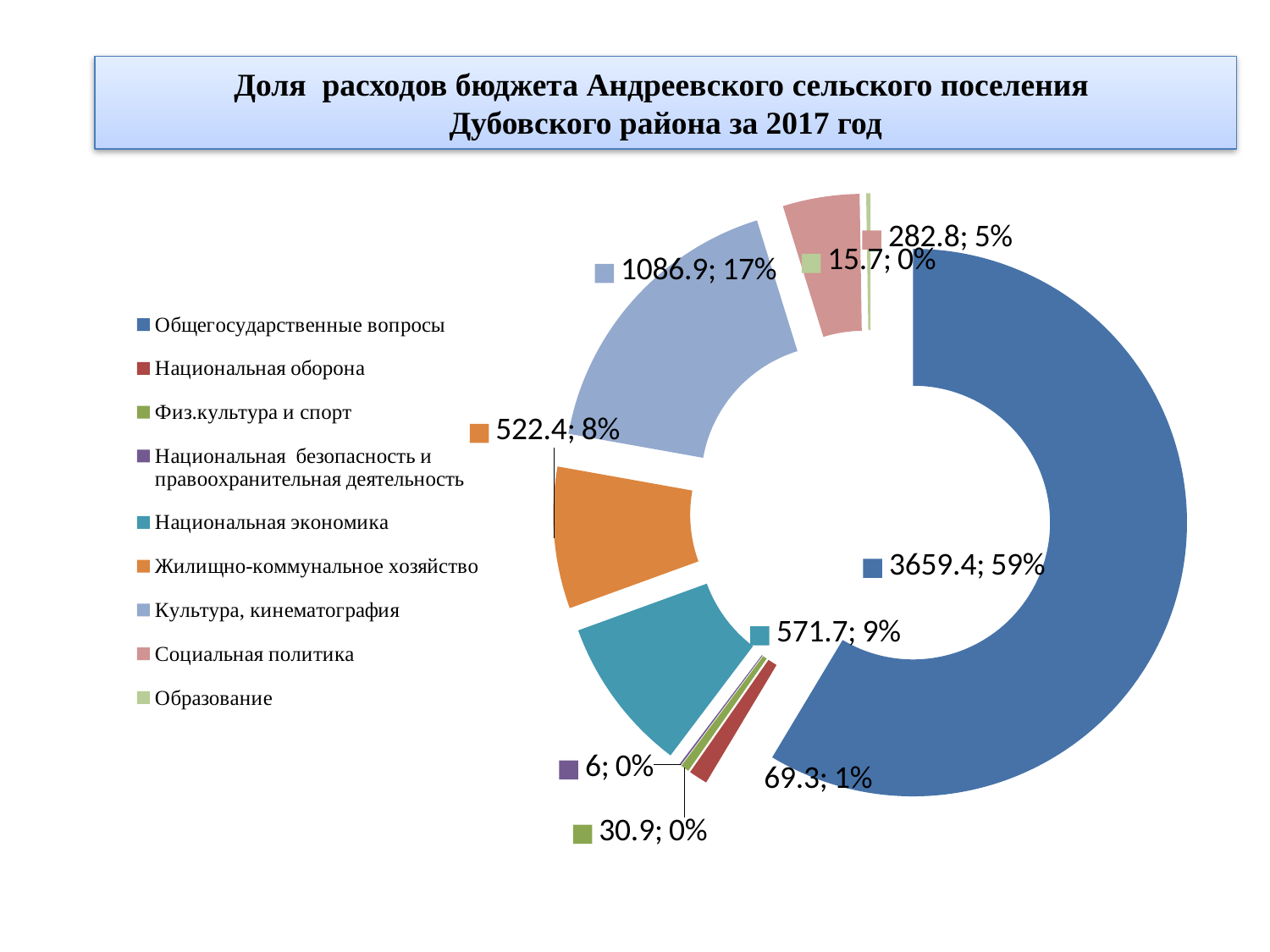
What share of the chart does Национальная экономика take? 9% Which is larger, the value for Социальная политика or the value for Национальная оборона? Социальная политика Which category has the largest value? Общегосударственные вопросы How many categories does the legend list? 9 What is the difference between the values for Национальная экономика and Жилищно-коммунальное хозяйство? 49.3 Which category has the smallest value? Национальная безопасность и правоохранительная деятельность What value is shown for Общегосударственные вопросы? 3659.4 What value is shown for Образование? 15.7 What value is shown for Жилищно-коммунальное хозяйство? 522.4 What value is shown for Культура, кинематография? 1086.9 What share of the chart does Общегосударственные вопросы take? 59% What kind of chart is shown on the slide? Doughnut (pie) chart